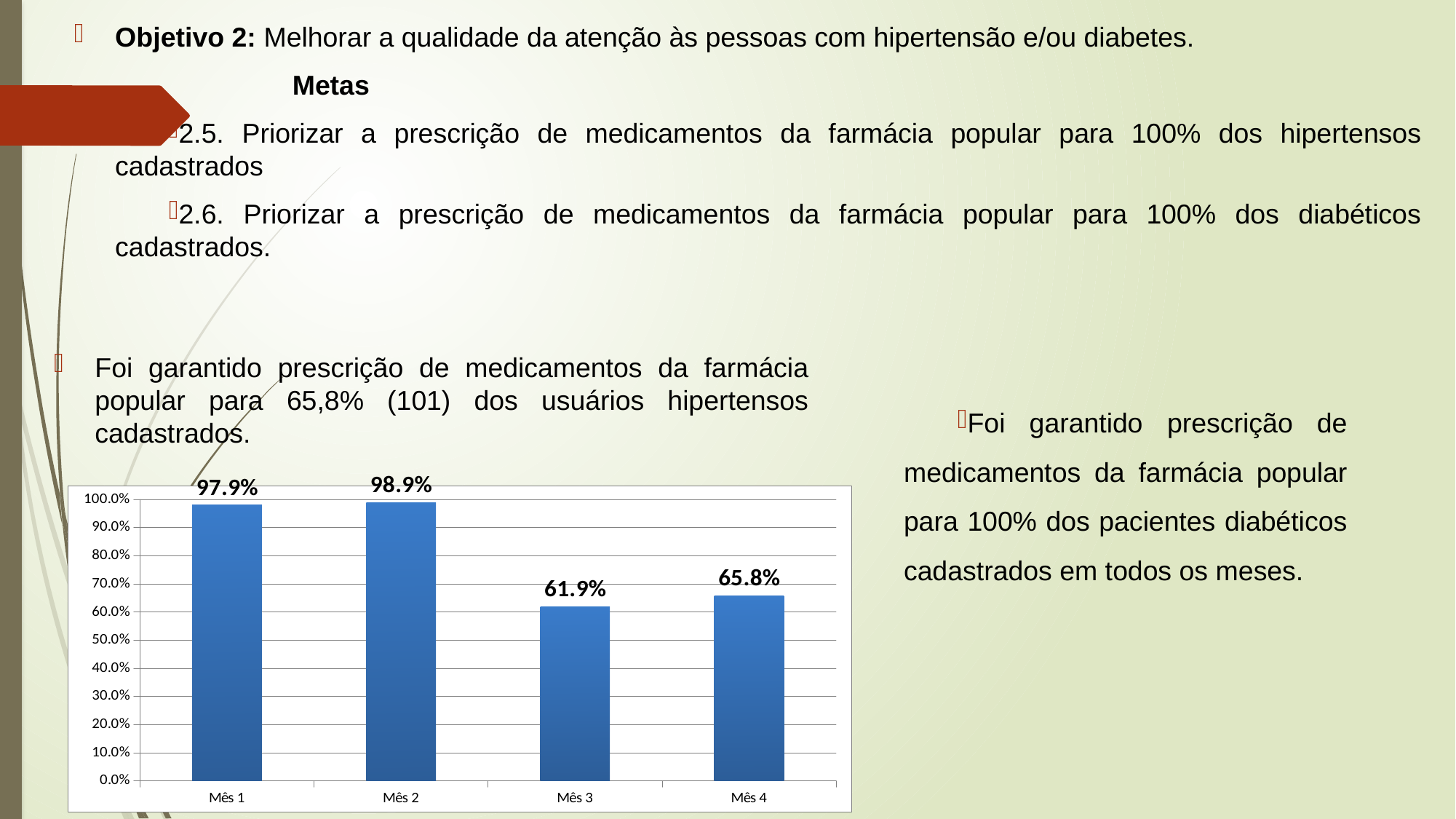
What is the value for Mês 3? 61.9% What is the value for Mês 4? 65.8% Is the value for Mês 3 greater or less than 70.0%? less Which month has the lowest value? Mês 3 What is the value for Mês 2? 98.9% How many months are shown on the x axis of the chart? 4 What is the highest tick value shown on the y axis of the chart? 100.0% Which month has the highest value? Mês 2 What is the difference between the values for Mês 2 and Mês 3? 37.0% What is the value for Mês 1? 97.9% Which is larger, the value for Mês 4 or the value for Mês 3? Mês 4 What kind of chart is shown on the slide? bar chart